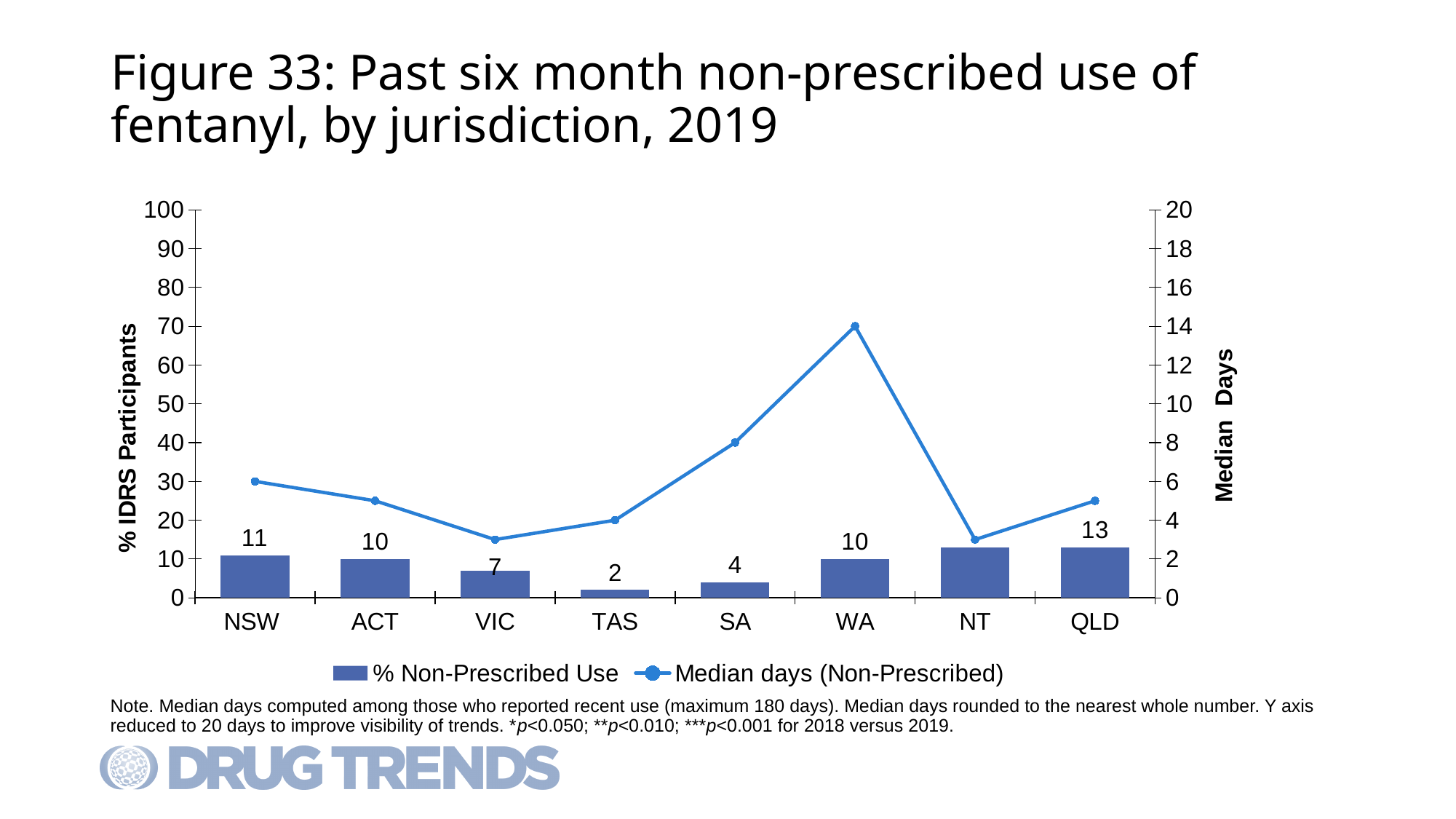
Is the % Non-Prescribed Use value for NT greater or less than 10? greater What is the median days (Non-Prescribed) value for SA? 8 Which jurisdiction has the lowest % Non-Prescribed Use? TAS Which jurisdiction has the highest median days (Non-Prescribed)? WA What is the median days (Non-Prescribed) value for WA? 14 What is the difference in % Non-Prescribed Use between QLD and VIC? 6 What is the % Non-Prescribed Use value for TAS? 2 Which has a higher % Non-Prescribed Use, SA or WA? WA How many series does the legend list? 2 How many jurisdictions are shown on the x axis? 8 What is the % Non-Prescribed Use value for NSW? 11 Is the median days (Non-Prescribed) value for VIC greater or less than 4? less